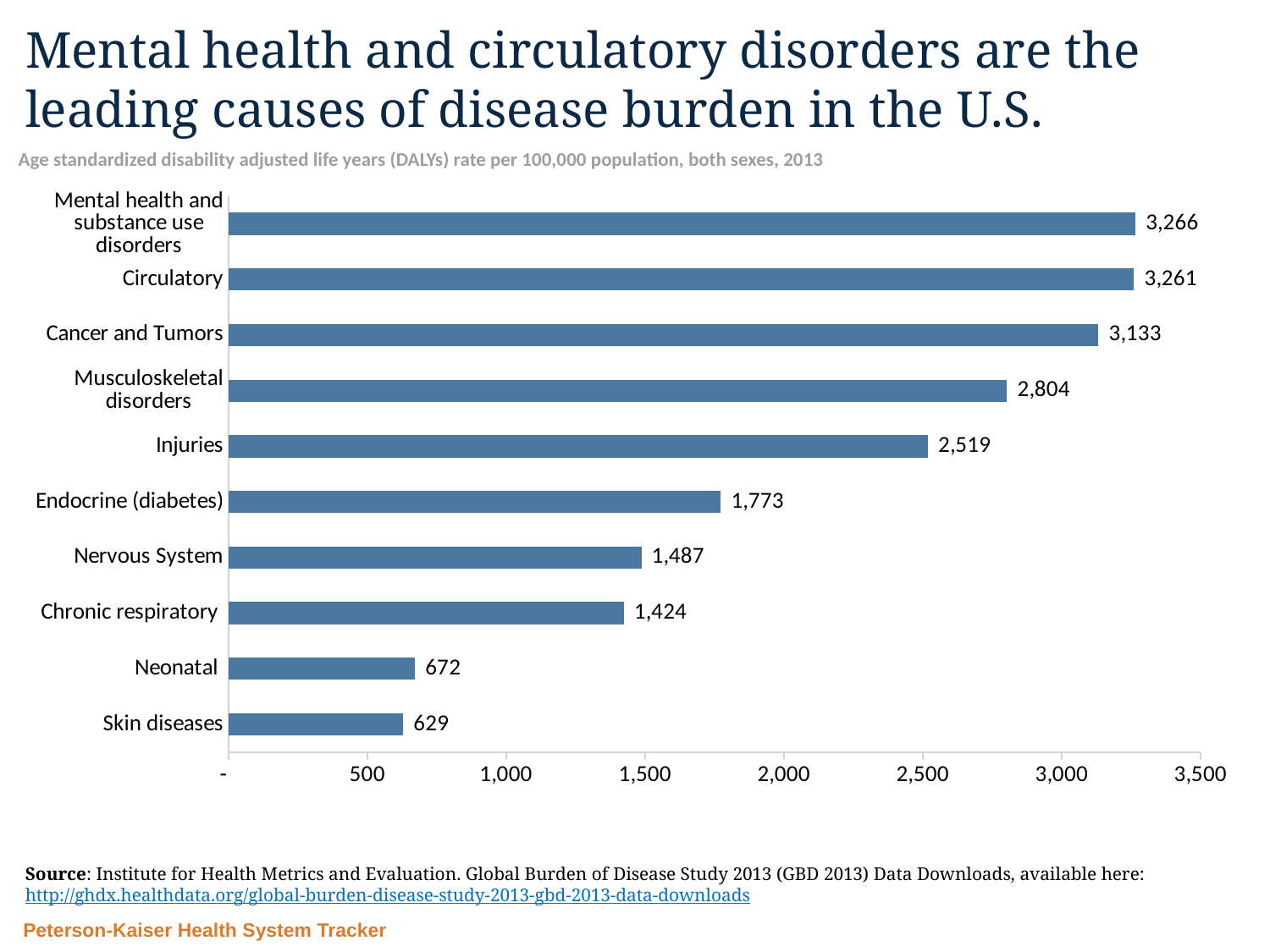
What year does the chart's data refer to, according to the subtitle? 2013 What is the DALY rate per 100,000 for Circulatory disorders? 3,261 Is the value for Musculoskeletal disorders greater or less than 2,500? greater Which category has the lowest DALY rate? Skin diseases What is the value shown for Neonatal? 672 Which category has the highest DALY rate? Mental health and substance use disorders Which is larger, the value for Nervous System or for Chronic respiratory? Nervous System What is the value shown for Injuries? 2,519 What is the difference between the values for Cancer and Tumors and Musculoskeletal disorders? 329 What is the difference between the values for Neonatal and Skin diseases? 43 What kind of chart is shown on the slide? Bar chart How many categories are shown in the chart? 10